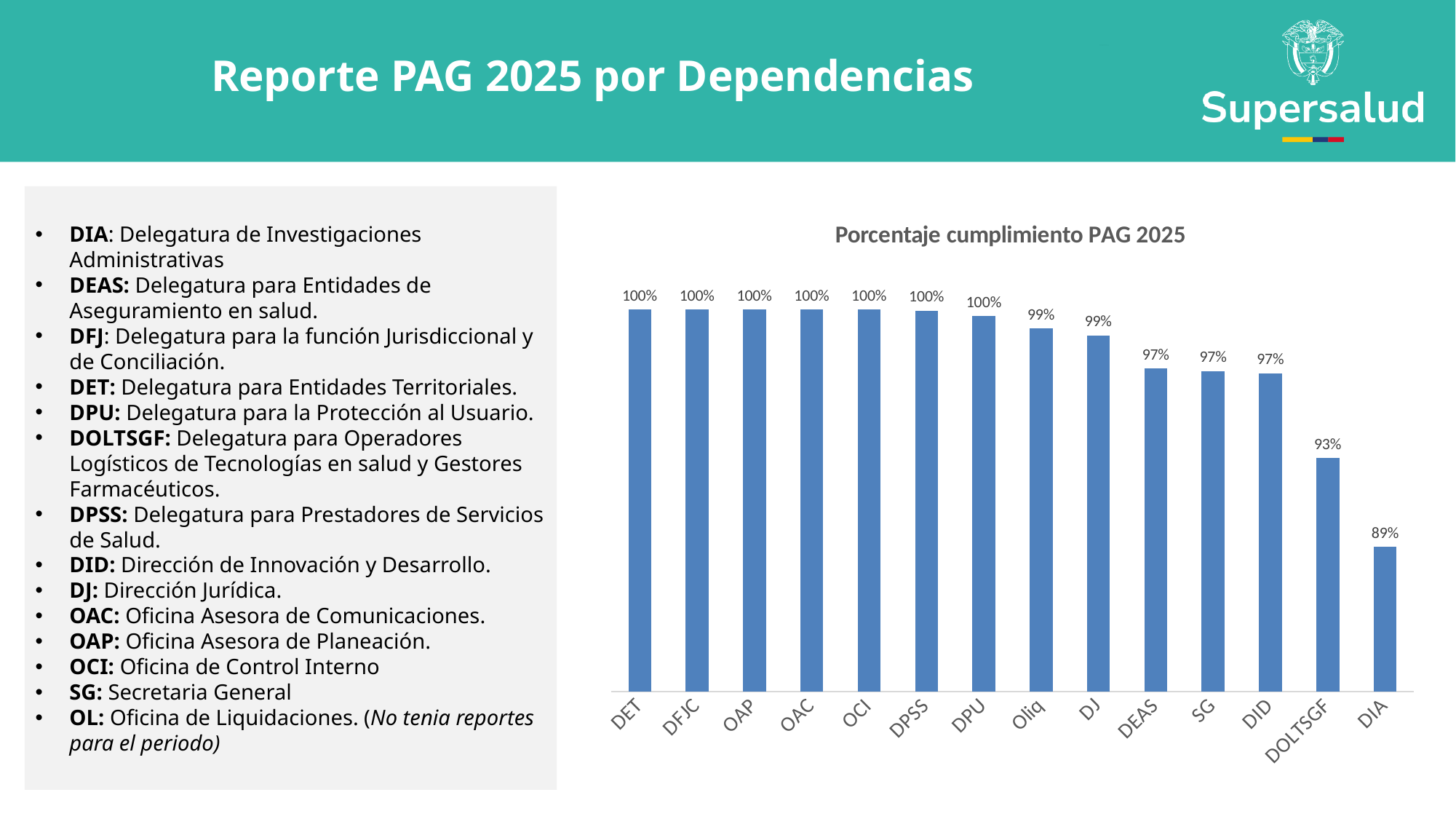
What kind of chart is shown on the slide? Bar chart What is the value for DJ in the chart? 99% Which dependency has the lowest percentage in the chart? DIA What is the value for DOLTSGF in the chart? 93% What is the value for SG in the chart? 97% What is the title of the chart? Porcentaje cumplimiento PAG 2025 Do the values generally rise or fall from left to right along the x axis? Fall What is the value for DIA in the chart? 89% Which is larger, the value for Oliq or the value for DID? Oliq How many dependencies (categories) are plotted in the chart? 14 What is the difference between the values for DEAS and DOLTSGF? 4% What is the difference between the values for DET and DIA? 11%